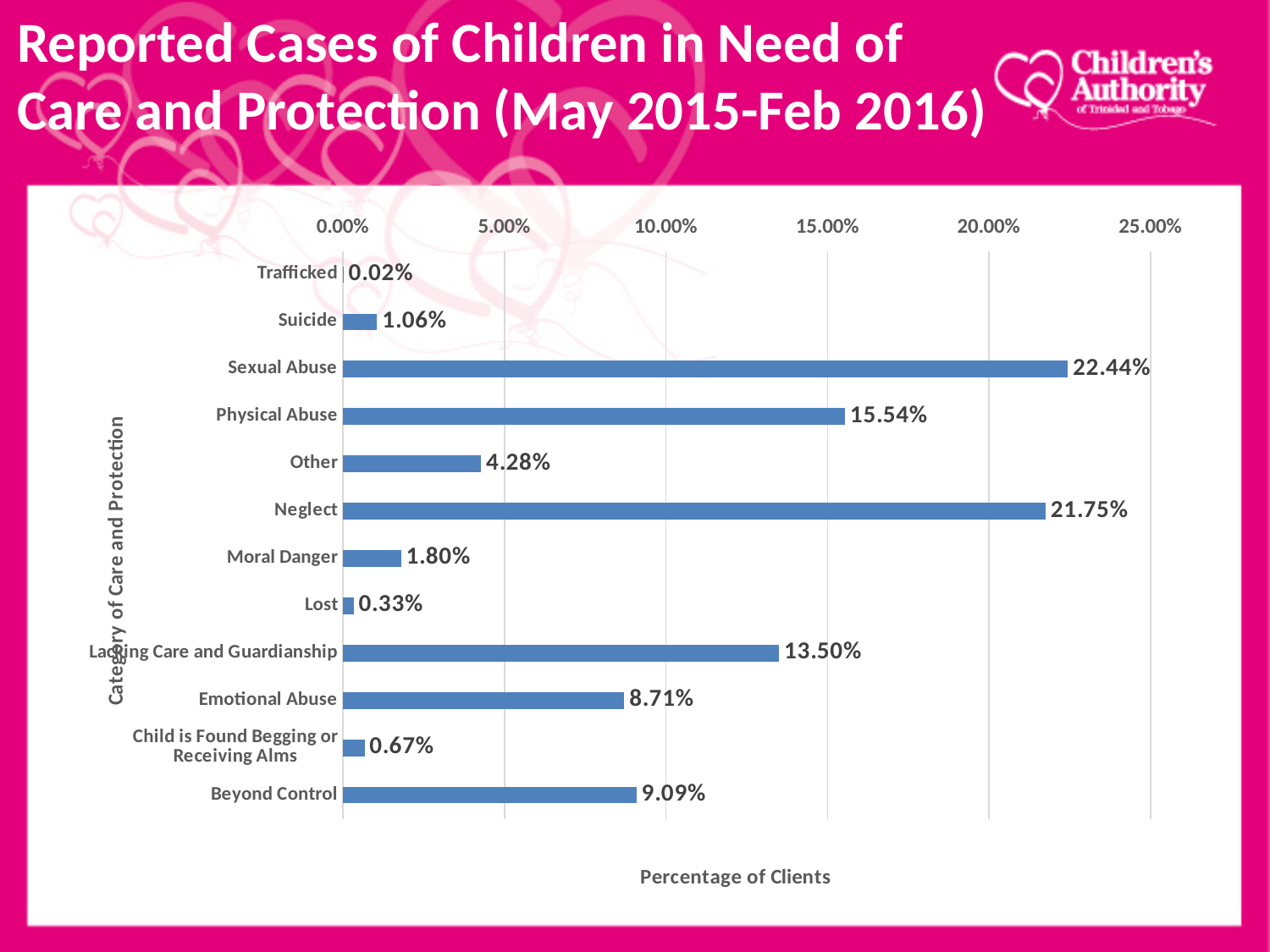
Is the value for Beyond Control greater or less than 10.00%? less What is the label of the horizontal axis? Percentage of Clients What percentage of clients is shown for Sexual Abuse? 22.44% Which category has the lowest percentage of clients? Trafficked Which category has the highest percentage of clients? Sexual Abuse What kind of chart is shown on the slide? bar chart What percentage is shown for Child is Found Begging or Receiving Alms? 0.67% How many categories are shown on the chart? 12 What is the difference between the values for Emotional Abuse and Other? 4.43% Which is larger, the value for Physical Abuse or the value for Lacking Care and Guardianship? Physical Abuse What is the difference between the values for Sexual Abuse and Neglect? 0.69% What is the value for Lacking Care and Guardianship? 13.50%